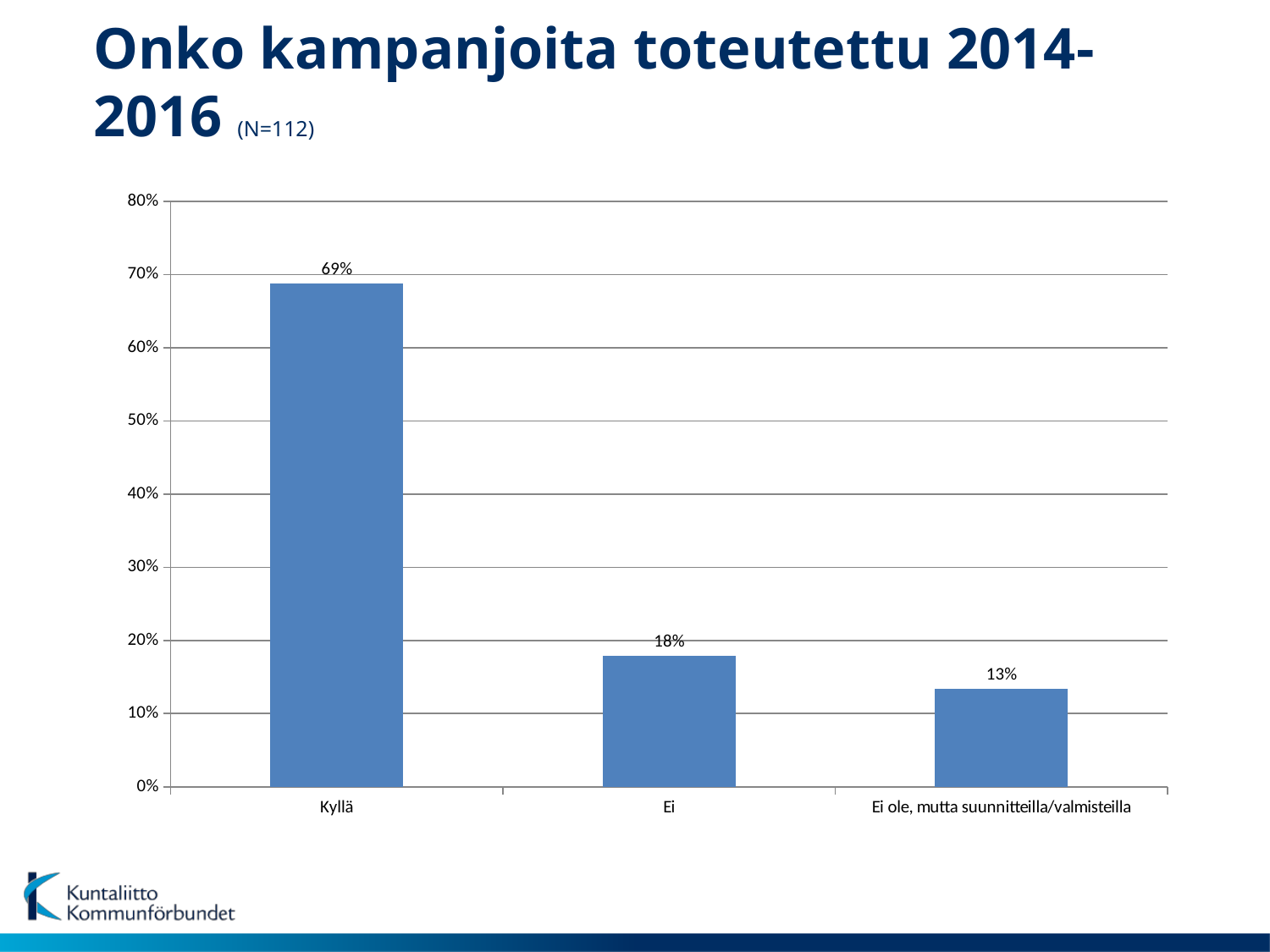
What is the value for Ei? 18% What kind of chart is shown on the slide? bar chart Which category has the lowest value? Ei ole, mutta suunnitteilla/valmisteilla How many categories are shown on the x axis? 3 Which category has the highest value? Kyllä What is the value for Kyllä? 69% Is the value for Kyllä greater or less than 60%? greater What is the difference between the values for Kyllä and Ei? 51% What is the difference between the values for Ei and Ei ole, mutta suunnitteilla/valmisteilla? 5% What is the sample size (N) given in the slide title? N=112 What is the value for Ei ole, mutta suunnitteilla/valmisteilla? 13% Which is larger, the value for Ei or the value for Ei ole, mutta suunnitteilla/valmisteilla? Ei